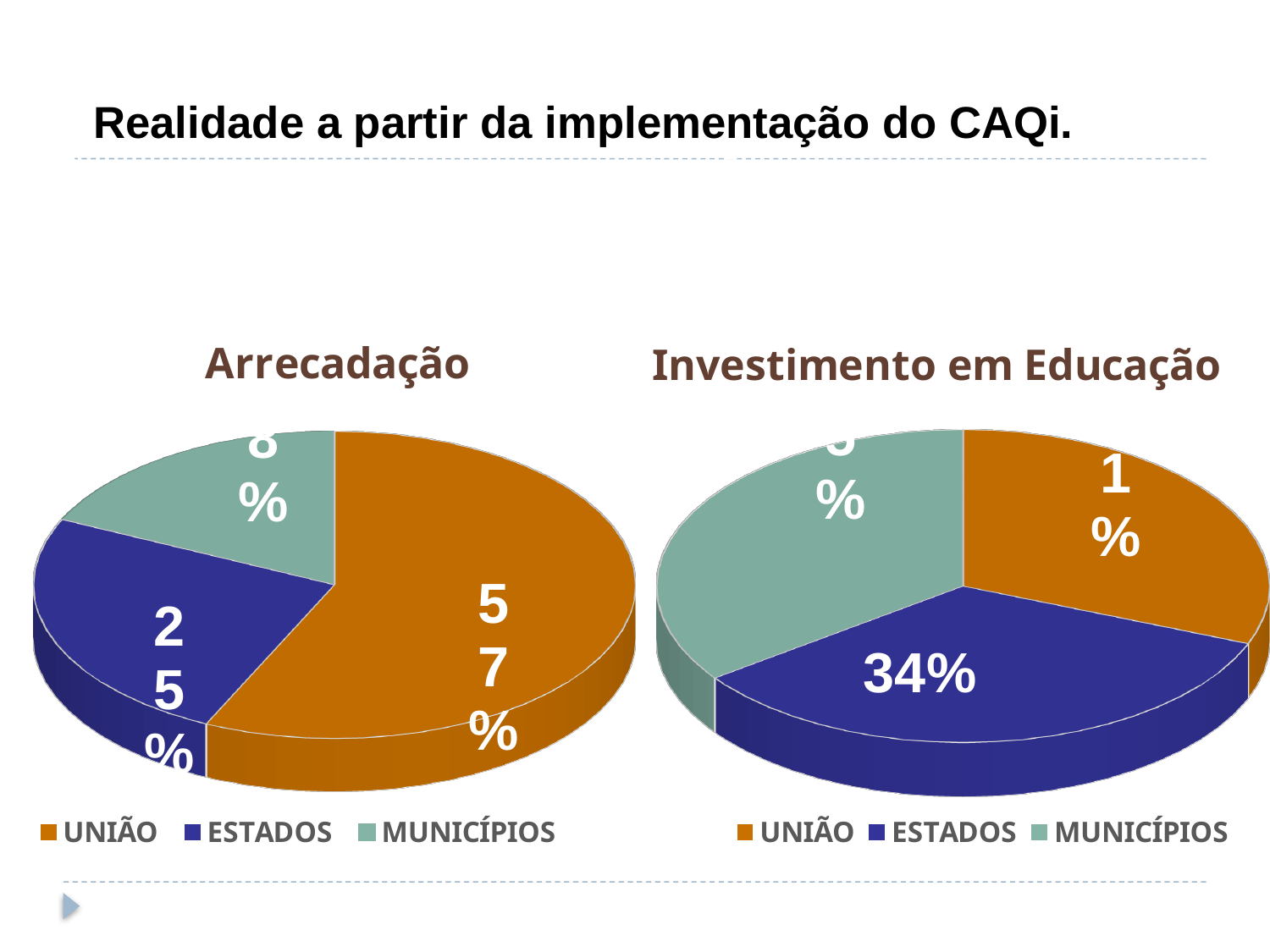
In the Arrecadação pie chart, what is the value for UNIÃO? 57% In the Arrecadação pie chart, which is larger, UNIÃO or ESTADOS? UNIÃO How many entries does the legend of the Arrecadação chart list? 3 In the Arrecadação pie chart, what is the difference in percentage points between UNIÃO and ESTADOS? 32 In the Arrecadação pie chart, which category has the largest slice? UNIÃO What type of chart is used for Investimento em Educação? Pie chart What is the title of the left chart on the slide? Arrecadação How many slices does the Investimento em Educação pie chart have? 3 In the Investimento em Educação pie chart, what is the value for ESTADOS? 34% In the Arrecadação pie chart, what is the value for ESTADOS? 25% In the Arrecadação pie chart, which category has the smallest slice? MUNICÍPIOS In the legends, which colour represents MUNICÍPIOS? Green